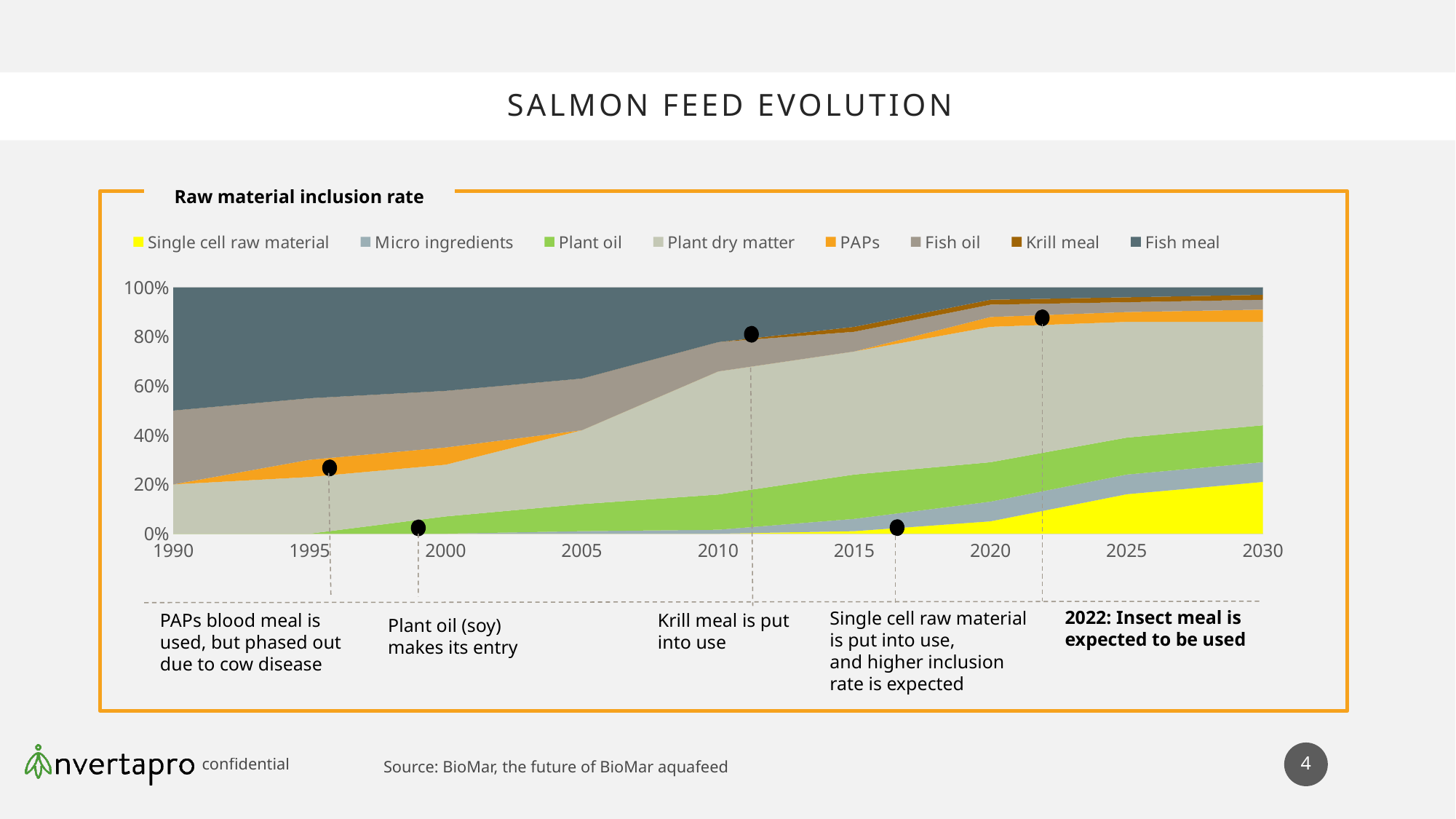
Which raw material has the largest share in 2030? Plant dry matter Which raw material has the largest share in 1990? Fish meal Does the share of Single cell raw material rise or fall from 2015 to 2030? Rise What is the title of the chart? Raw material inclusion rate How many series does the legend of the 'Raw material inclusion rate' chart list? 8 How many year labels are shown on the x axis of the chart? 9 Does the share of Fish meal rise or fall from 1990 to 2030? Fall In 2030, which has the larger share: Plant oil or Fish meal? Plant oil What kind of chart is shown on the slide? Stacked area chart Is the share of Plant dry matter in 1990 greater or less than 40%? less Is the share of Fish meal in 2030 greater or less than 20%? less Which colour represents Single cell raw material in the legend? Yellow